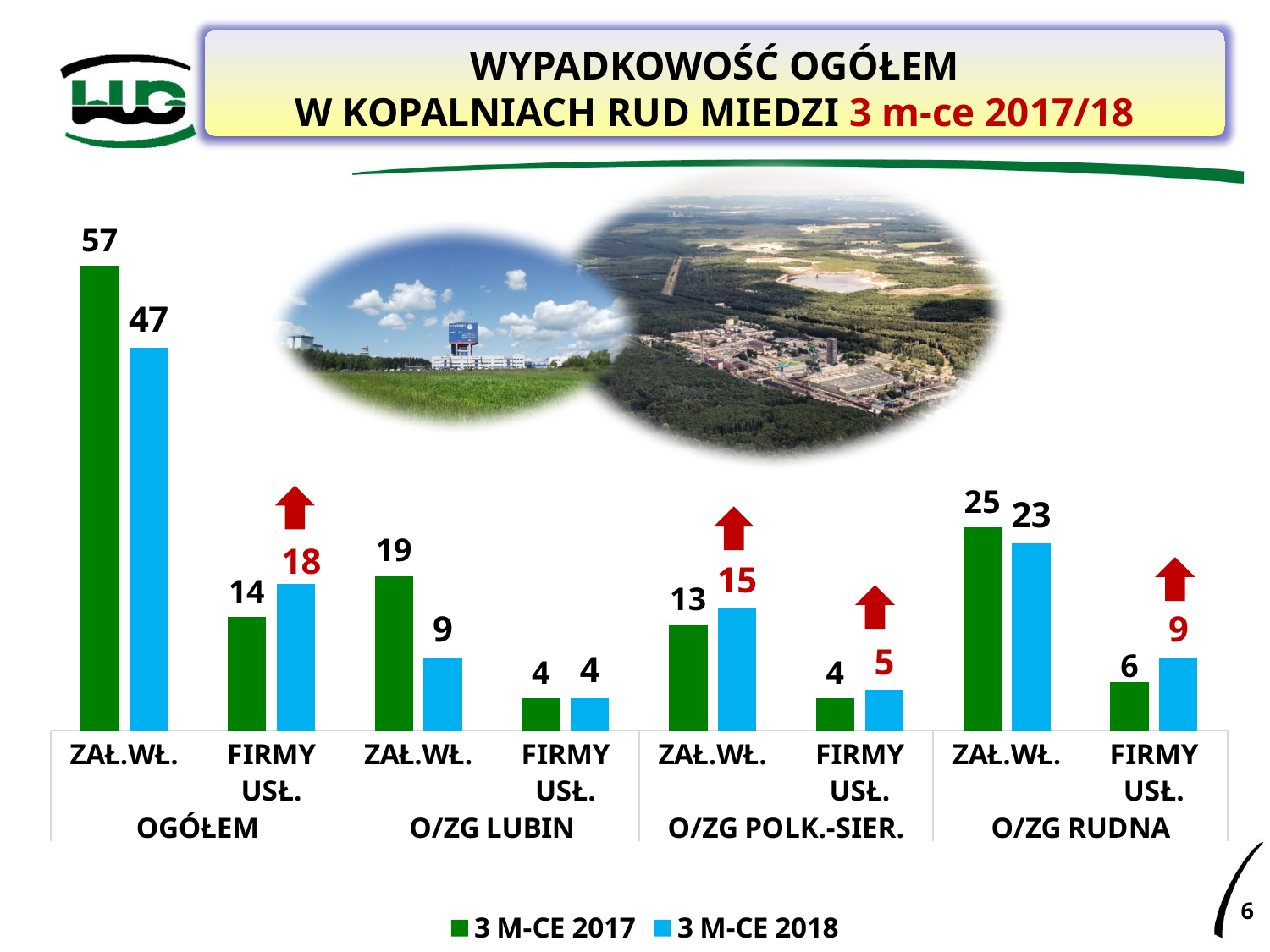
What is the value for FIRMY USŁ. in the O/ZG POLK.-SIER. group for the 3 M-CE 2017 series? 4 Which colour represents the 3 M-CE 2018 series? Blue For FIRMY USŁ. in the O/ZG RUDNA group, which series has the larger value, 3 M-CE 2017 or 3 M-CE 2018? 3 M-CE 2018 How many series does the legend list? 2 What is the value for FIRMY USŁ. in the O/ZG LUBIN group for the 3 M-CE 2018 series? 4 What is the value for ZAŁ.WŁ. in the O/ZG RUDNA group for the 3 M-CE 2018 series? 23 What is the value for ZAŁ.WŁ. in the OGÓŁEM group for the 3 M-CE 2017 series? 57 What is the difference between the 3 M-CE 2017 and 3 M-CE 2018 values for ZAŁ.WŁ. in the O/ZG LUBIN group? 10 Which category has the lowest value in the 3 M-CE 2017 series? FIRMY USŁ. (O/ZG LUBIN and O/ZG POLK.-SIER., both 4) What kind of chart is shown on the slide? Bar chart What is the difference between the 3 M-CE 2017 and 3 M-CE 2018 values for ZAŁ.WŁ. in the OGÓŁEM group? 10 Which category has the highest value in the 3 M-CE 2018 series? ZAŁ.WŁ. (OGÓŁEM)